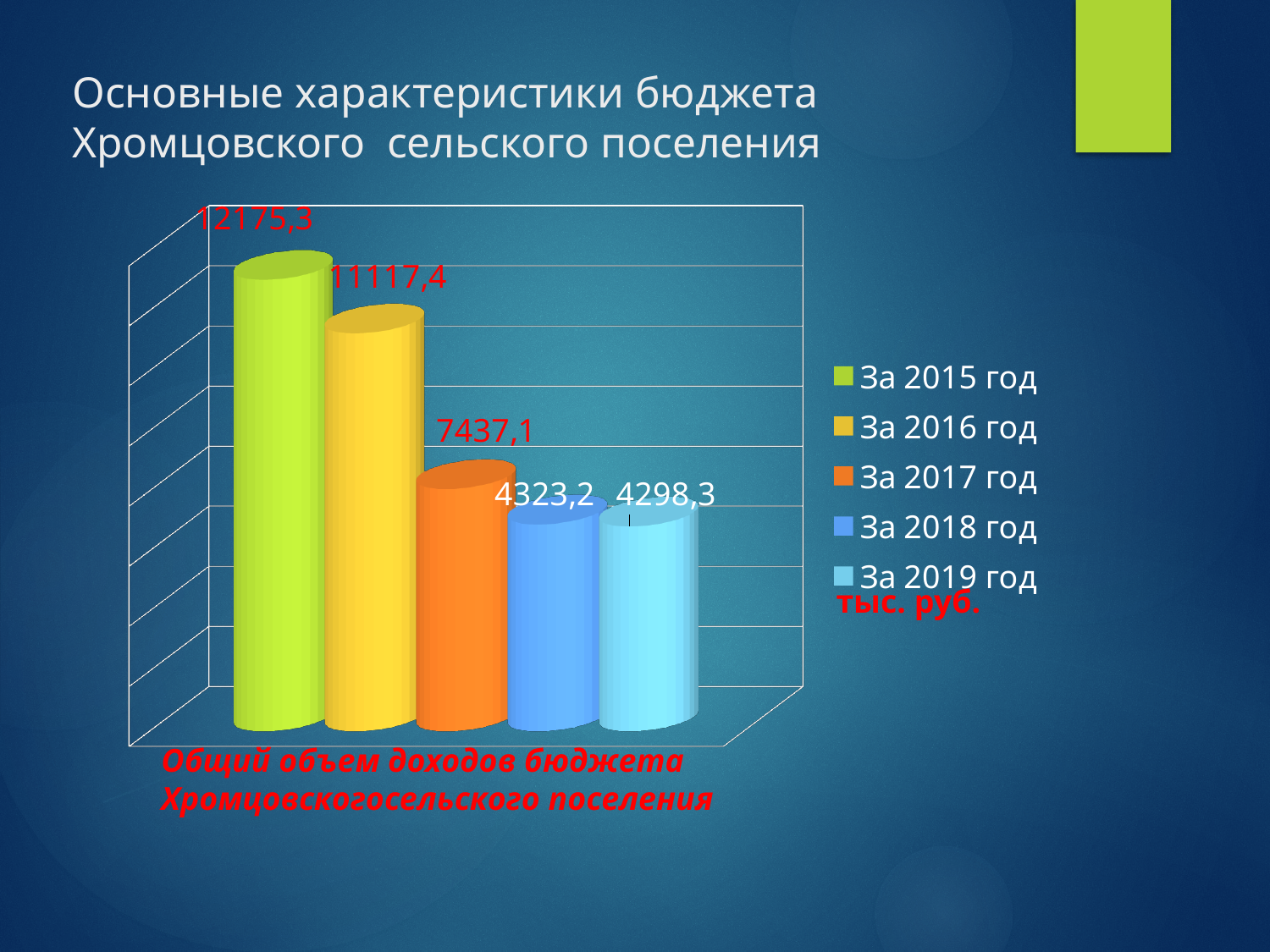
What unit is indicated for the values on the chart? тыс. руб. What is the value for За 2019 год? 4298,3 Which is larger, the value for За 2016 год or the value for За 2017 год? За 2016 год What is the difference between the values for За 2015 год and За 2016 год? 1057,9 What is the value for За 2017 год? 7437,1 Which year has the lowest value? За 2019 год What is the value for За 2015 год? 12175,3 What kind of chart is shown on the slide? Bar chart What is the difference between the values for За 2018 год and За 2019 год? 24,9 Do the values rise or fall from За 2015 год to За 2019 год? Fall Which year has the highest value? За 2015 год How many series does the legend list? 5